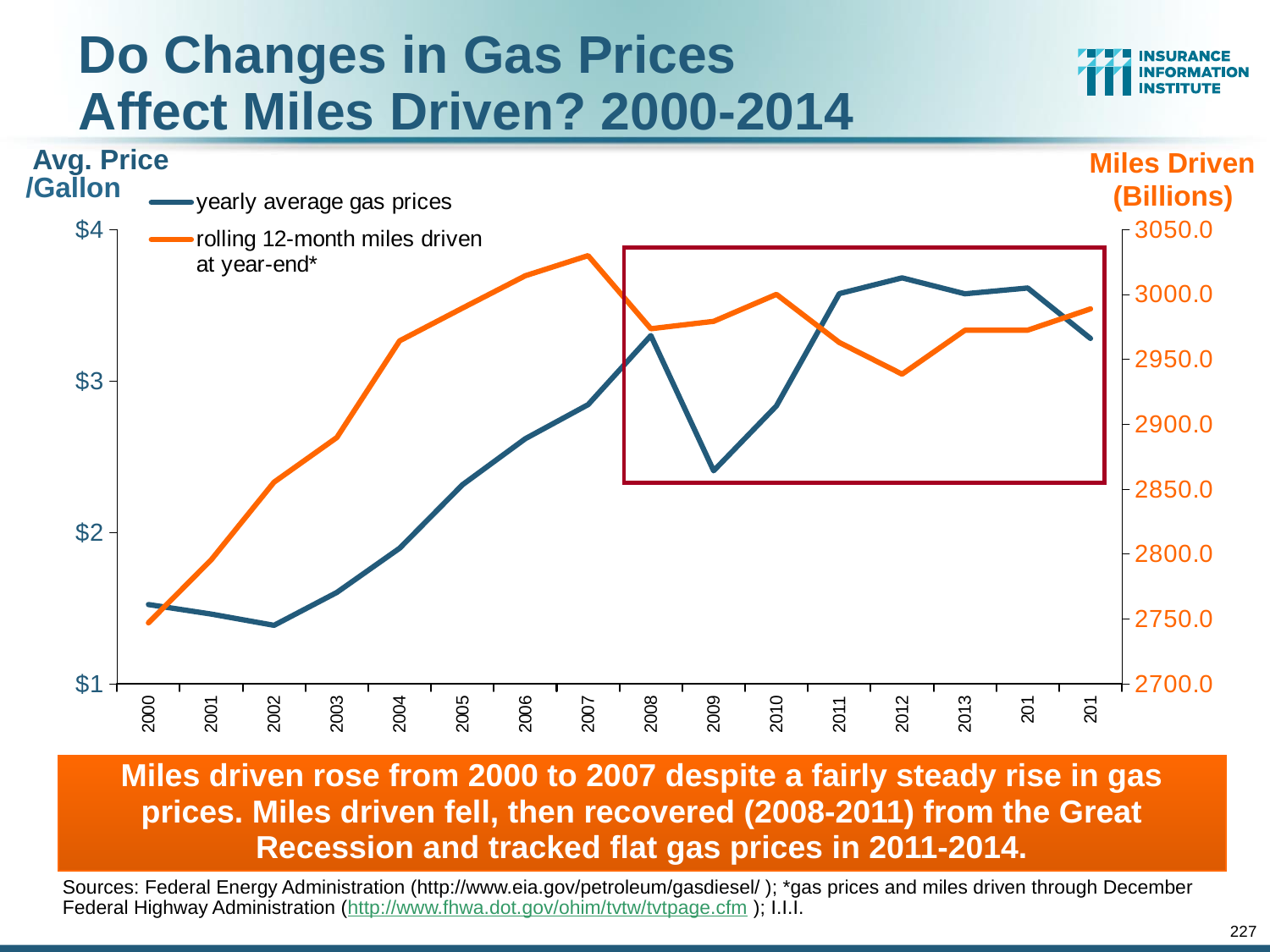
What is the label of the right-hand vertical axis? Miles Driven (Billions) Are rolling 12-month miles driven for 2007 greater or less than 3000.0? greater In which year were rolling 12-month miles driven highest? 2007 In which year was the yearly average gas price highest? 2012 Is the yearly average gas price for 2012 greater or less than $3? greater Which series is plotted in orange? rolling 12-month miles driven at year-end* Is the yearly average gas price for 2002 greater or less than $2? less Which year had the higher yearly average gas price, 2008 or 2009? 2008 In which year were rolling 12-month miles driven lowest? 2000 How many series does the legend list? 2 What kind of chart is shown on the slide? line chart In which year was the yearly average gas price lowest? 2002